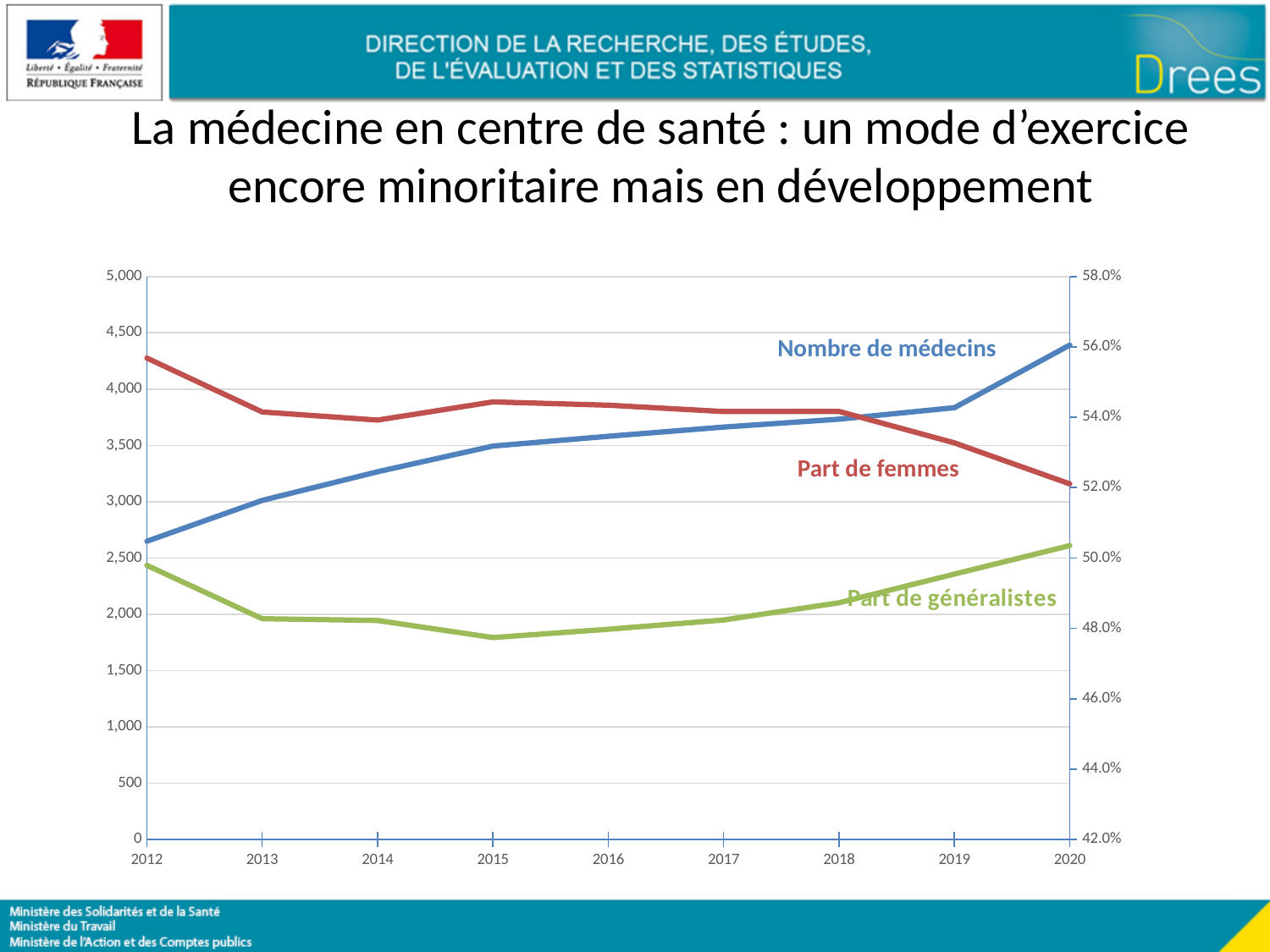
Is the value for 'Nombre de médecins' in 2012 greater or less than 3,000? less How many series are plotted on the chart? 3 In which year is 'Part de généralistes' lowest? 2015 Does the 'Part de généralistes' line rise or fall from 2015 to 2020? rise Does the 'Part de femmes' line rise or fall from 2012 to 2020? fall Is the value for 'Nombre de médecins' in 2020 greater or less than 4,000? greater Does the 'Nombre de médecins' line rise or fall from 2012 to 2020? rise Is the value for 'Part de femmes' in 2012 greater or less than 54.0%? greater What kind of chart is shown on the slide? line chart How many years are shown along the x axis of the chart? 9 In which year is 'Nombre de médecins' highest? 2020